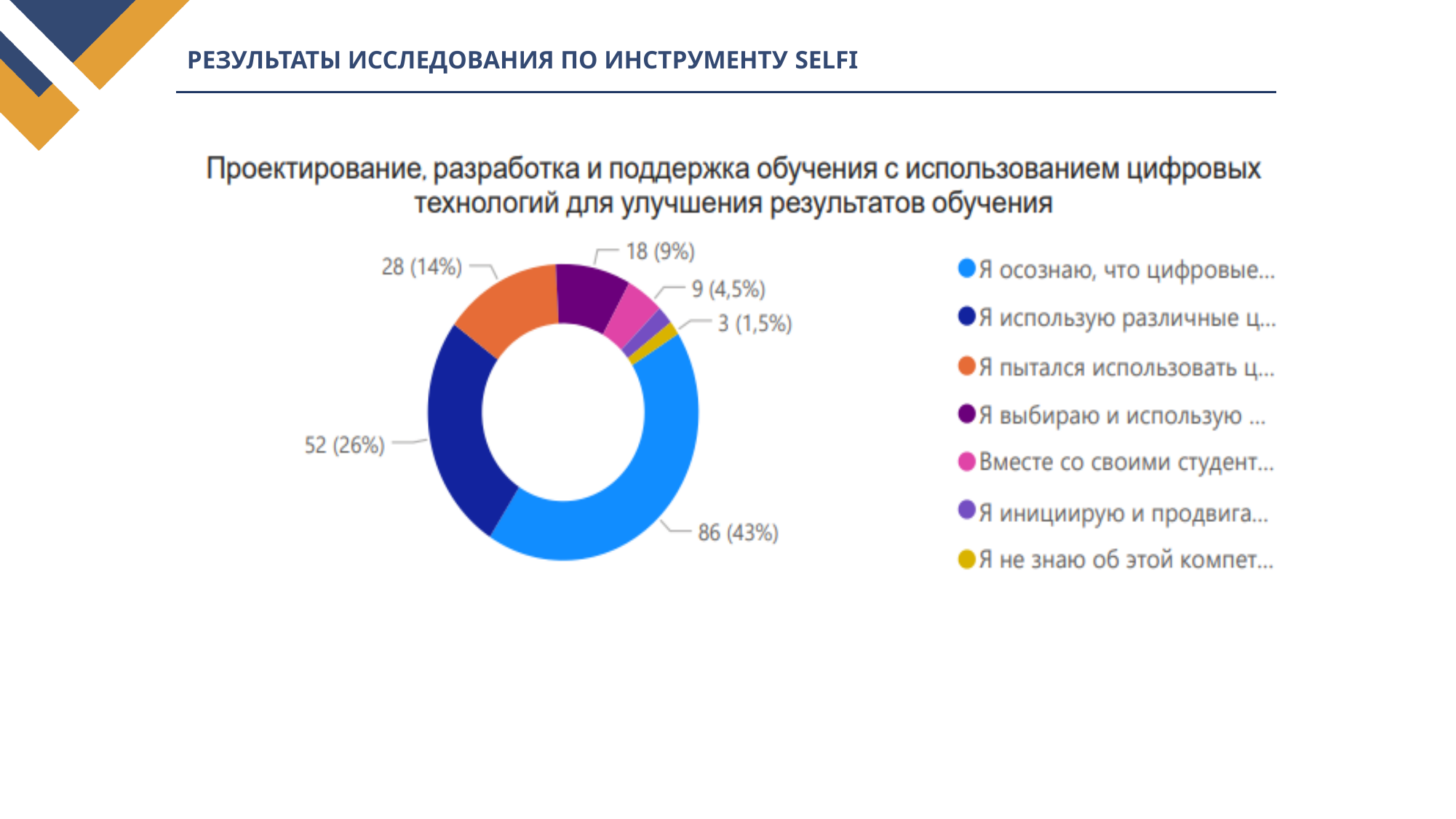
What value is shown for the slice "Я использую различные ц..."? 52 (26%) What value is shown for the slice "Я пытался использовать ц..."? 28 (14%) What share of the chart does "Я осознаю, что цифровые..." represent? 43% Which is larger: "Я пытался использовать ц..." or "Я выбираю и использую ..."? Я пытался использовать ц... What kind of chart is shown on the slide? pie chart (donut) What is the smallest value printed on the chart? 3 (1,5%) What is the difference in count between "Я осознаю, что цифровые..." and "Я использую различные ц..."? 34 Which category has the largest slice of the chart? Я осознаю, что цифровые... How many entries does the legend list? 7 What value is shown for the slice "Я выбираю и использую ..."? 18 (9%) What value is shown for the slice "Вместе со своими студент..."? 9 (4,5%) What value is shown for the slice "Я осознаю, что цифровые..."? 86 (43%)